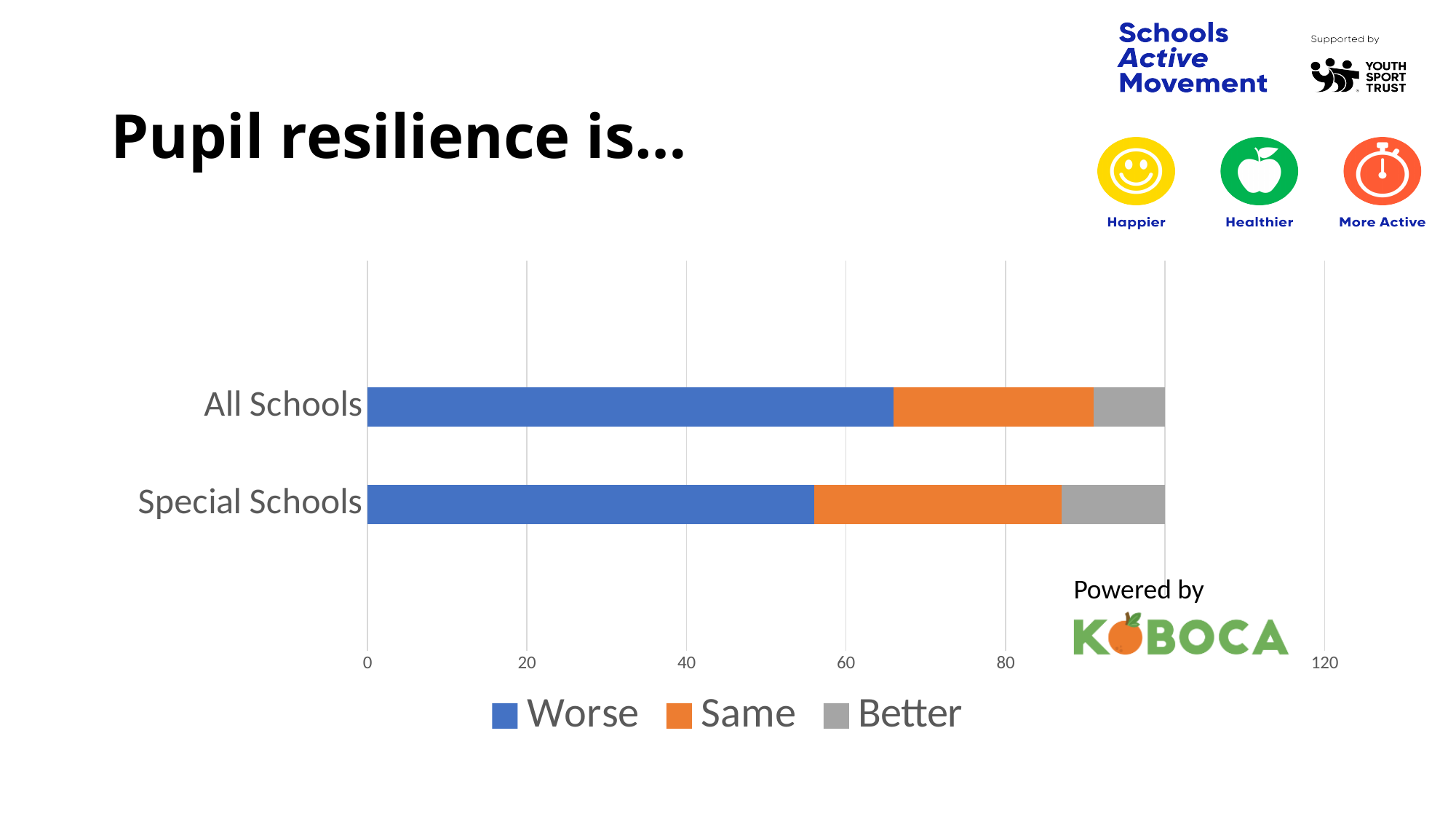
Which category has the larger 'Better' value, All Schools or Special Schools? Special Schools Is the 'Worse' value for All Schools greater or less than 60? greater Which series has the largest segment in the All Schools bar? Worse How many categories are plotted on the chart? 2 Which category has the larger 'Worse' value, All Schools or Special Schools? All Schools Which category has the larger 'Same' value, All Schools or Special Schools? Special Schools What are the three series listed in the legend? Worse, Same, Better Is the 'Worse' value for Special Schools greater or less than 40? greater Is the 'Worse' value for Special Schools greater or less than 60? less Which colour represents the 'Worse' series in the chart? blue What kind of chart is shown on the slide? bar chart How many series does the chart's legend list? 3